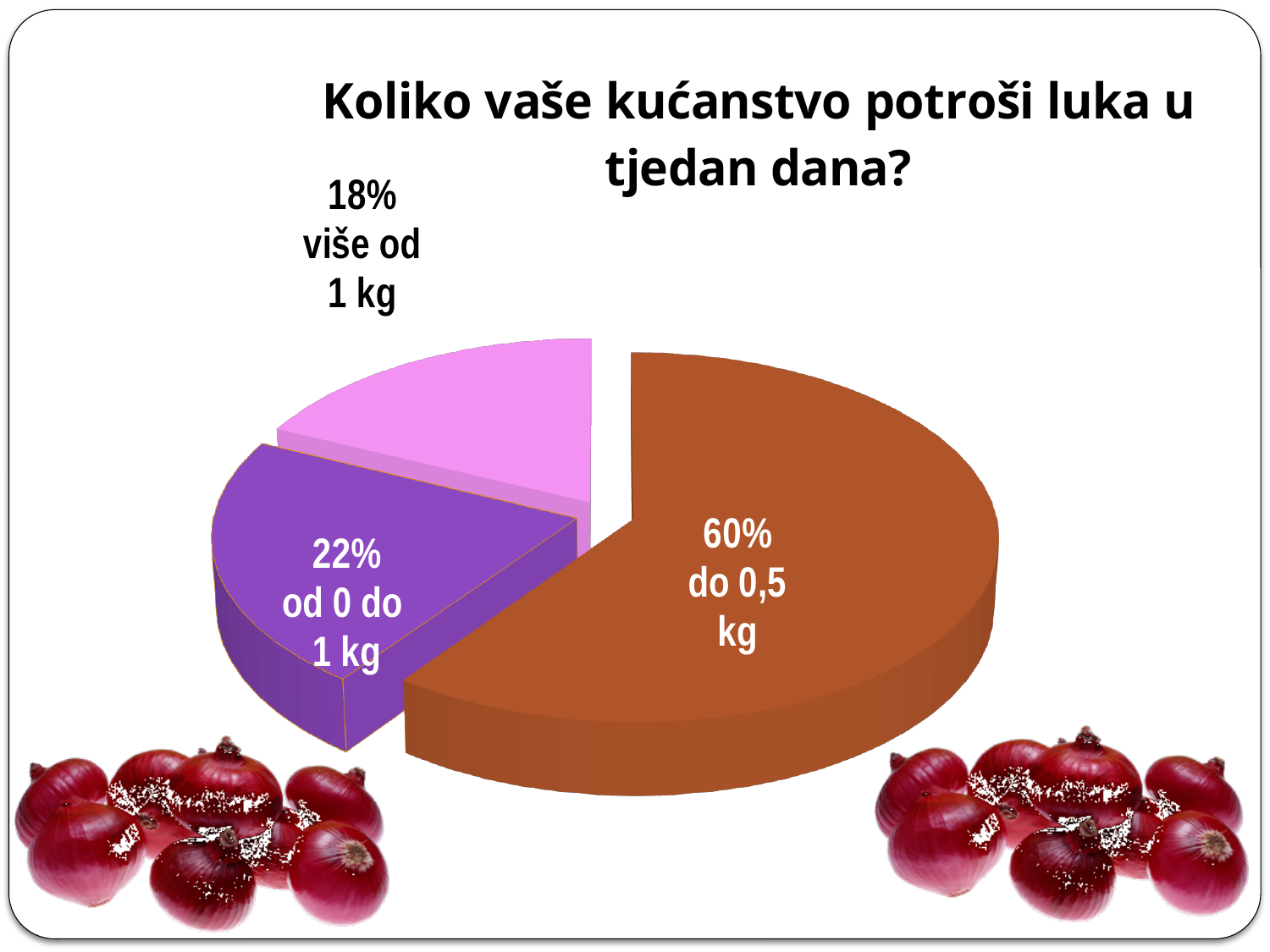
What share of the pie does the 'od 0 do 1 kg' slice represent? 22% What is the difference in percentage points between the 'do 0,5 kg' slice and the 'od 0 do 1 kg' slice? 38 What share of the pie does the 'više od 1 kg' slice represent? 18% Which category has the largest share of the pie? do 0,5 kg What colour is the 'do 0,5 kg' slice? brown What share of the pie does the 'do 0,5 kg' slice represent? 60% Which is larger: the share for 'od 0 do 1 kg' or the share for 'više od 1 kg'? od 0 do 1 kg Which category has the smallest share of the pie? više od 1 kg What is the title of the chart? Koliko vaše kućanstvo potroši luka u tjedan dana? What is the difference in percentage points between the 'od 0 do 1 kg' slice and the 'više od 1 kg' slice? 4 How many slices does the pie chart have? 3 What kind of chart is shown on the slide? pie chart